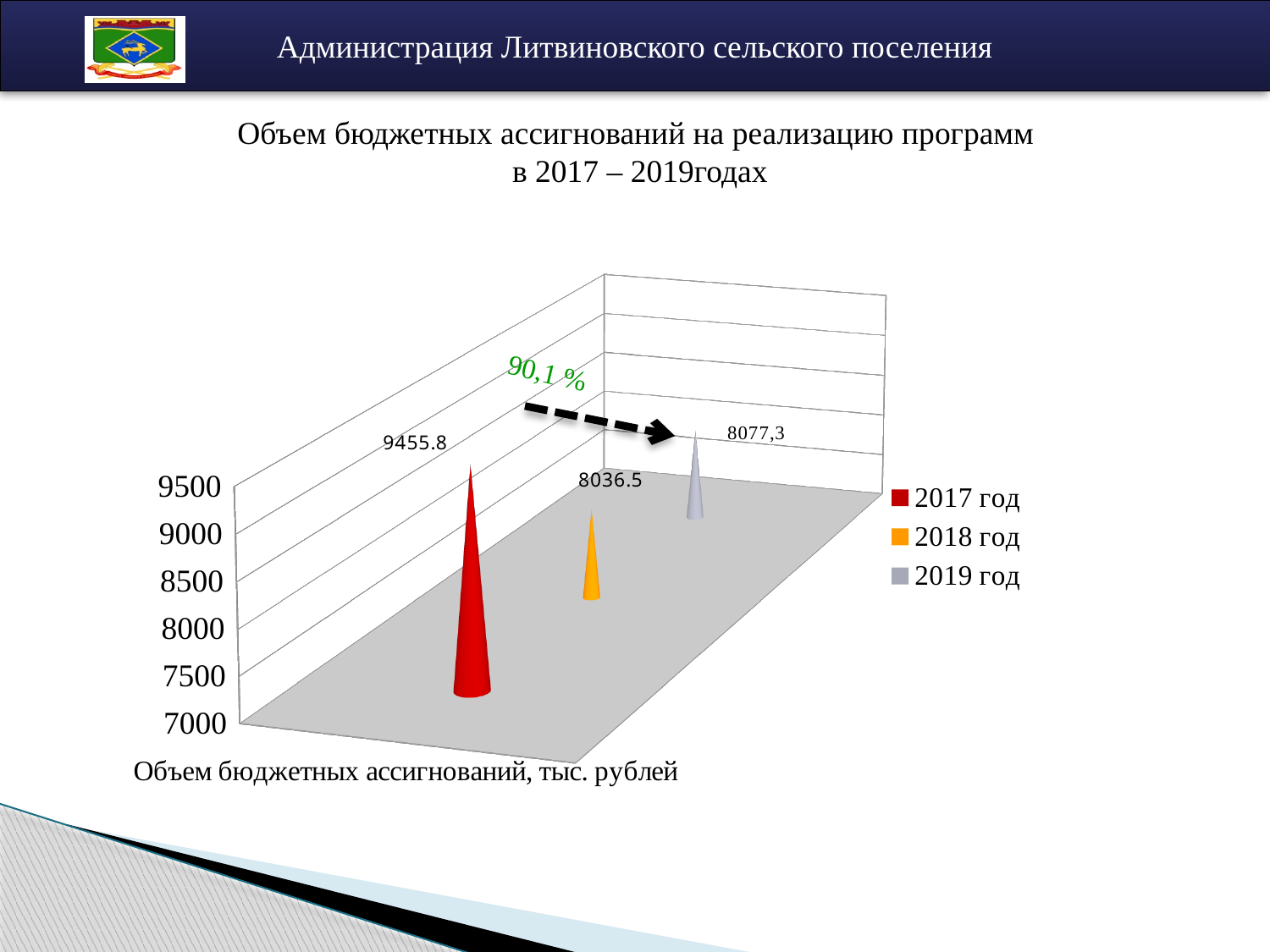
What is the value for 2019 год? 8077,3 What percentage is written next to the dashed arrow on the chart? 90,1 % What is the value for 2018 год? 8036.5 Which year has the highest volume of budget allocations? 2017 год What is the value for 2017 год? 9455.8 How many series does the legend list? 3 What is the difference between the values for 2017 год and 2018 год? 1419.3 Is the value for 2017 год greater or less than 9000? greater What kind of chart is shown on the slide? bar chart Which year has the lowest volume of budget allocations? 2018 год Which is larger, the value for 2017 год or the value for 2019 год? 2017 год Does the value rise or fall from 2017 год to 2018 год? fall